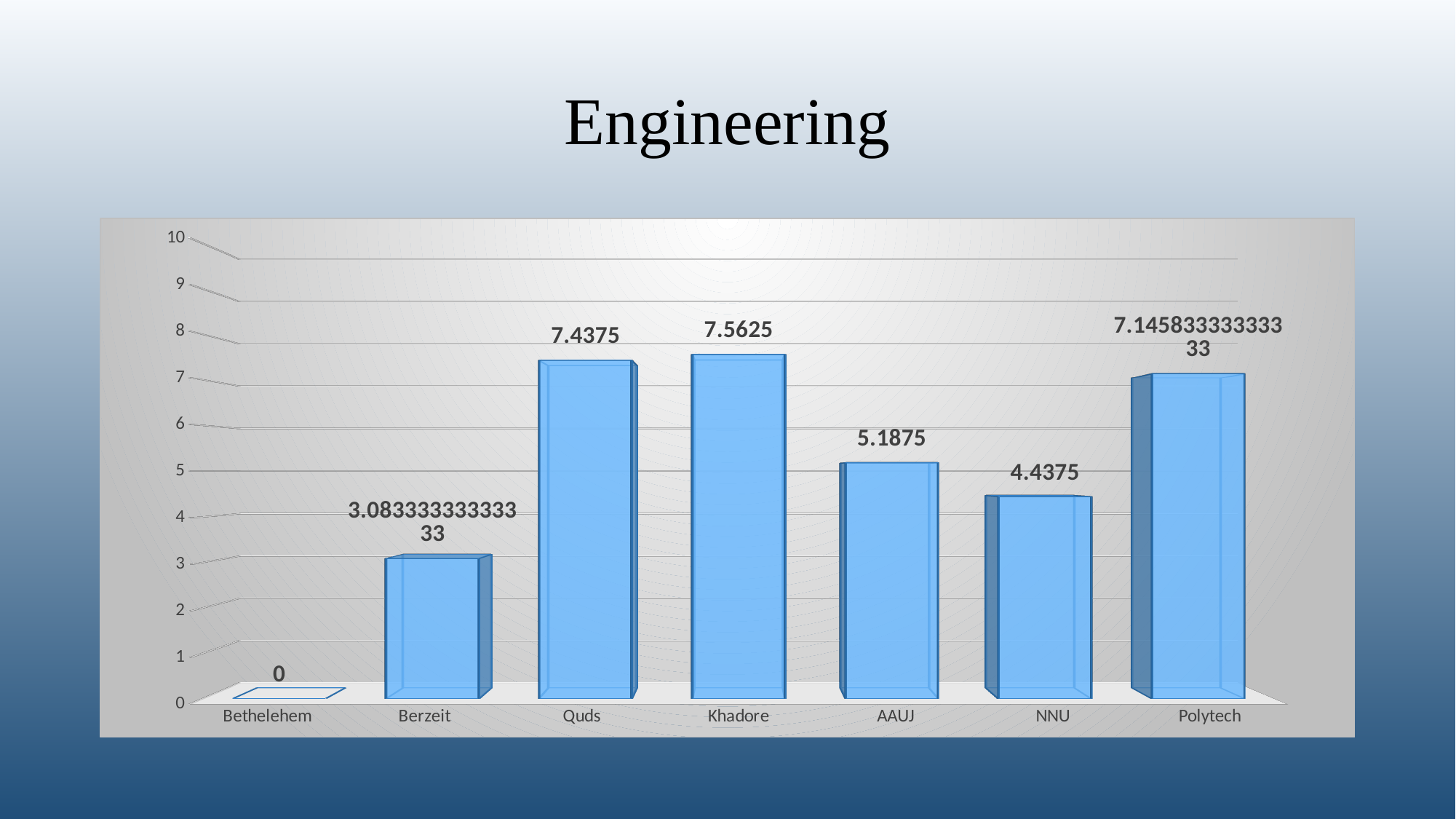
What kind of chart is shown on the slide? Bar chart What is the difference between the values for Khadore and Quds? 0.125 What is the value for Berzeit? 3.08333333333333 How many categories are shown on the x axis? 7 Which category has the lowest value? Bethelehem What is the value for Quds? 7.4375 What is the title of the slide? Engineering Which category has the highest value? Khadore What is the value for NNU? 4.4375 What is the difference between the values for AAUJ and NNU? 0.75 Which is larger, the value for AAUJ or the value for NNU? AAUJ What is the value for Polytech? 7.14583333333333